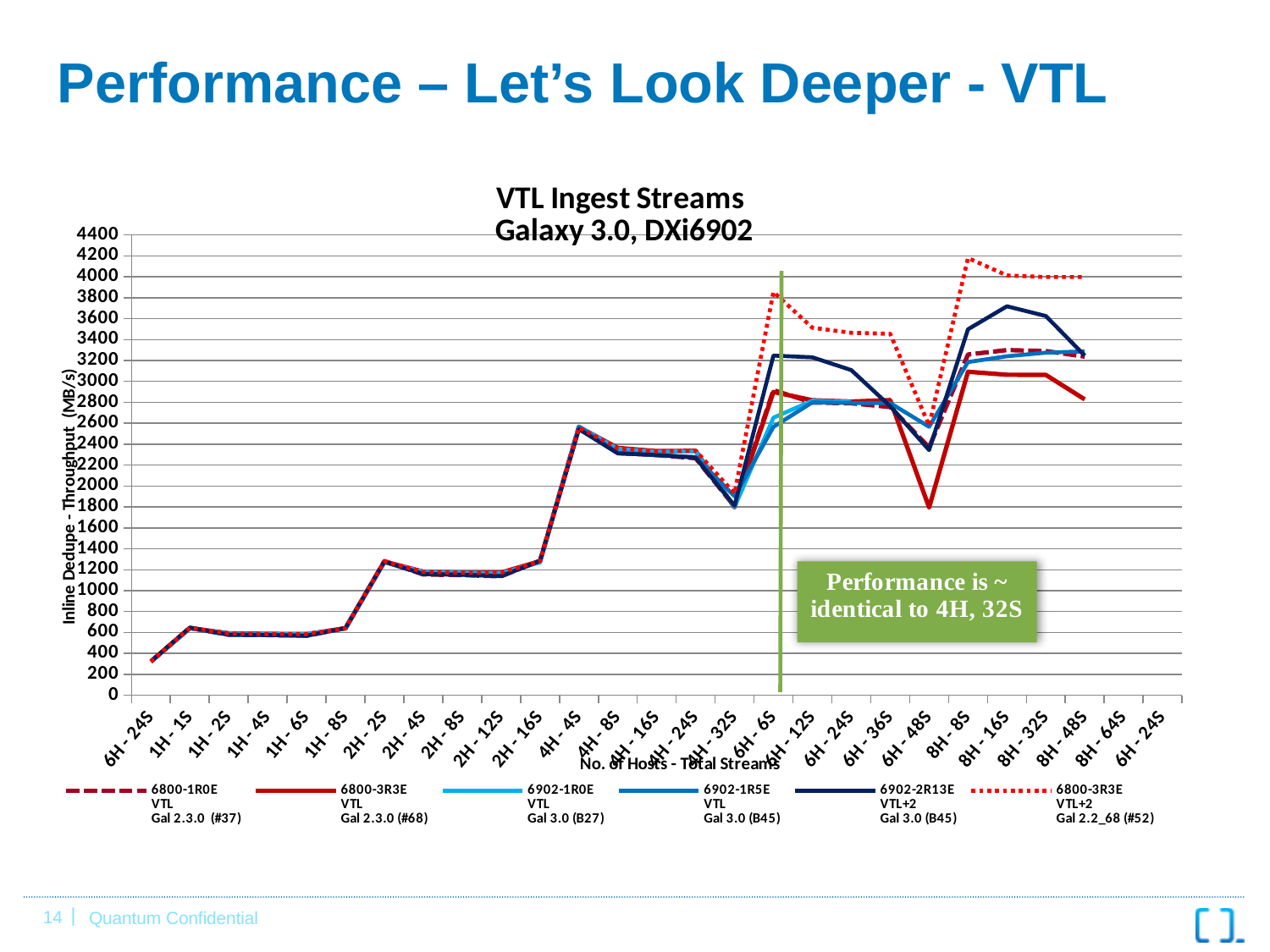
Overall, do the throughput values rise or fall moving from the 1H categories to the 8H categories along the x axis? rise How many series does the legend list? 6 Is the highest value reached by the 6800-3R3E VTL+2 Gal 2.2_68 (#52) series greater or less than 4000? greater Is the value for 6800-1R0E VTL Gal 2.3.0 (#37) at 1H - 1S greater or less than 400? greater Is the value for 6800-1R0E VTL Gal 2.3.0 (#37) at 1H - 1S greater or less than 800? less What kind of chart is shown on the slide? line chart What is the title of the chart? VTL Ingest Streams Galaxy 3.0, DXi6902 Which series reaches the highest throughput on the chart? 6800-3R3E VTL+2 Gal 2.2_68 (#52) What is the label of the vertical axis? Inline Dedupe - Throughput (MB/s)